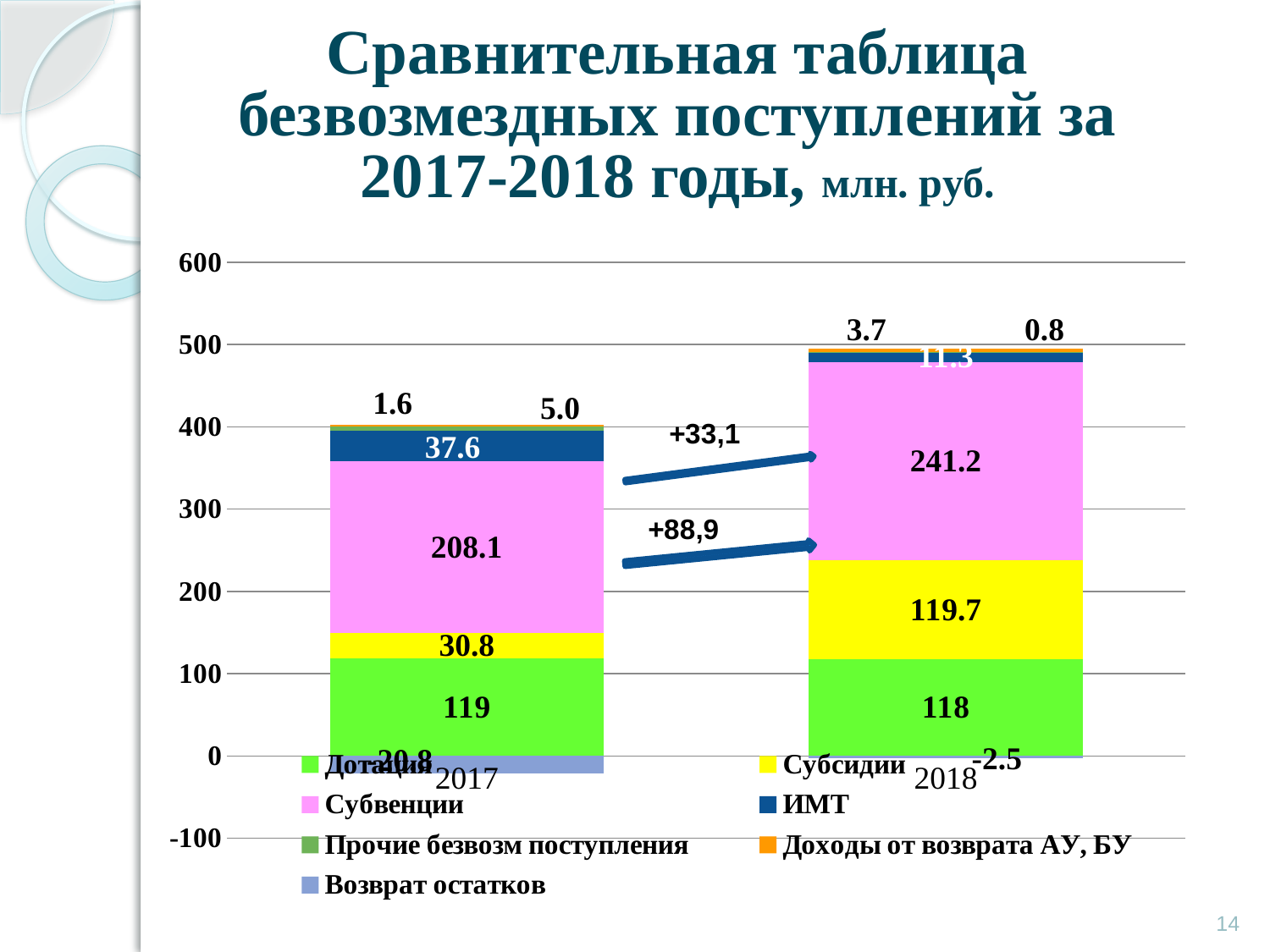
What is the value of Субвенции for 2017? 208.1 What is the value of Доходы от возврата АУ, БУ for 2017? 1.6 Which series has the largest value in the 2018 bar? Субвенции By how much did Субвенции increase from 2017 to 2018? 33.1 Which year has the larger value for Дотация, 2017 or 2018? 2017 What is the value of Субсидии for 2018? 119.7 What kind of chart is shown on the slide? Stacked bar chart What is the value of ИМТ for 2017? 37.6 By how much did Субсидии increase from 2017 to 2018? 88.9 How many series does the legend list? 7 How many years (categories) are shown on the x axis? 2 What is the value of Прочие безвозм поступления for 2018? 0.8